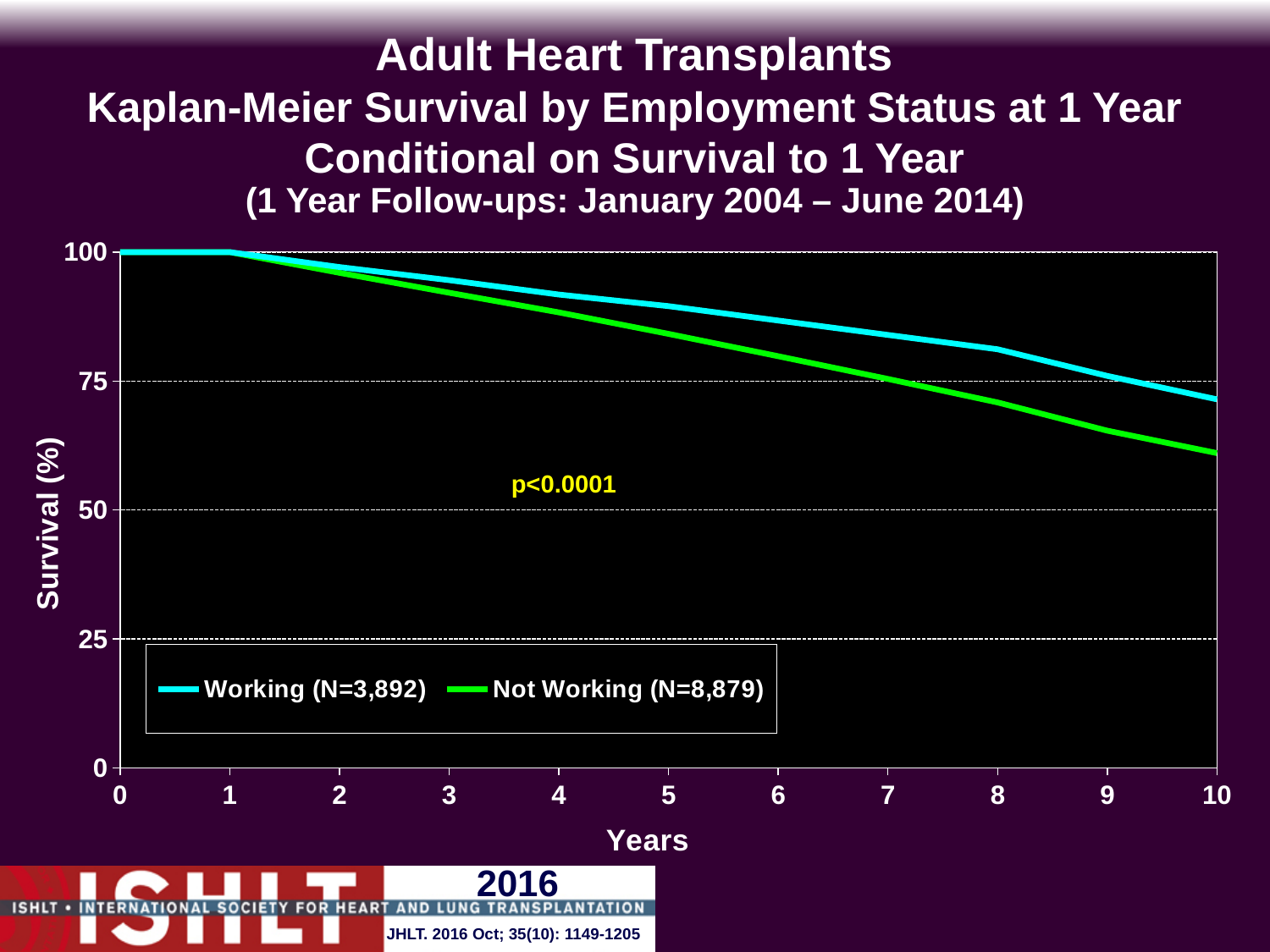
What is the N for the Working group shown in the legend? 3,892 What kind of chart is shown on the slide? Line chart What p-value is printed on the chart? p<0.0001 Is the survival for the Not Working group at 10 years greater or less than 75? less Is the survival for the Working group at 10 years greater or less than 50? greater At 10 years, which group has the higher survival, Working or Not Working? Working What is the N for the Not Working group shown in the legend? 8,879 Do the survival curves rise or fall as years increase? Fall What is the label of the y axis? Survival (%) Is the survival for the Working group at 5 years greater or less than 75? greater What is the maximum value shown on the x axis (Years)? 10 How many series does the legend list? 2